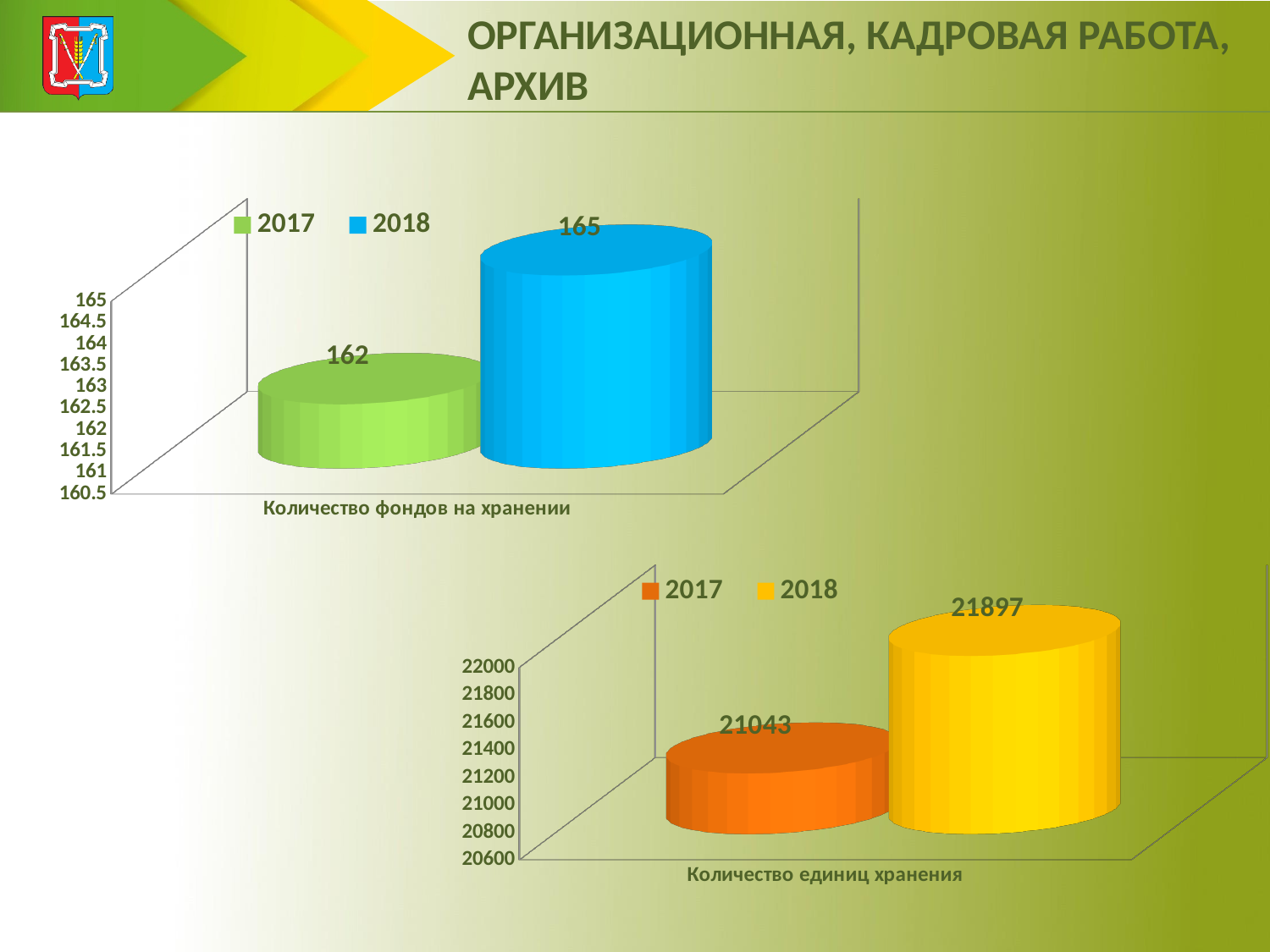
In the bottom chart (Количество единиц хранения), what is the difference between the 2018 and 2017 values? 854 In the bottom chart (Количество единиц хранения), what is the value for 2017? 21043 In the bottom chart (Количество единиц хранения), which year has the lower value? 2017 In the bottom chart (Количество единиц хранения), what colour is the bar for 2018? yellow What kind of chart is the bottom chart (Количество единиц хранения)? bar chart In the top chart (Количество фондов на хранении), what is the value for 2017? 162 In the top chart (Количество фондов на хранении), which year has the higher value? 2018 How many series does the legend of the top chart (Количество фондов на хранении) list? 2 In the bottom chart (Количество единиц хранения), is the value for 2017 greater or less than 21200? less In the top chart (Количество фондов на хранении), what is the value for 2018? 165 In the top chart (Количество фондов на хранении), what is the difference between the 2018 and 2017 values? 3 In the bottom chart (Количество единиц хранения), what is the value for 2018? 21897